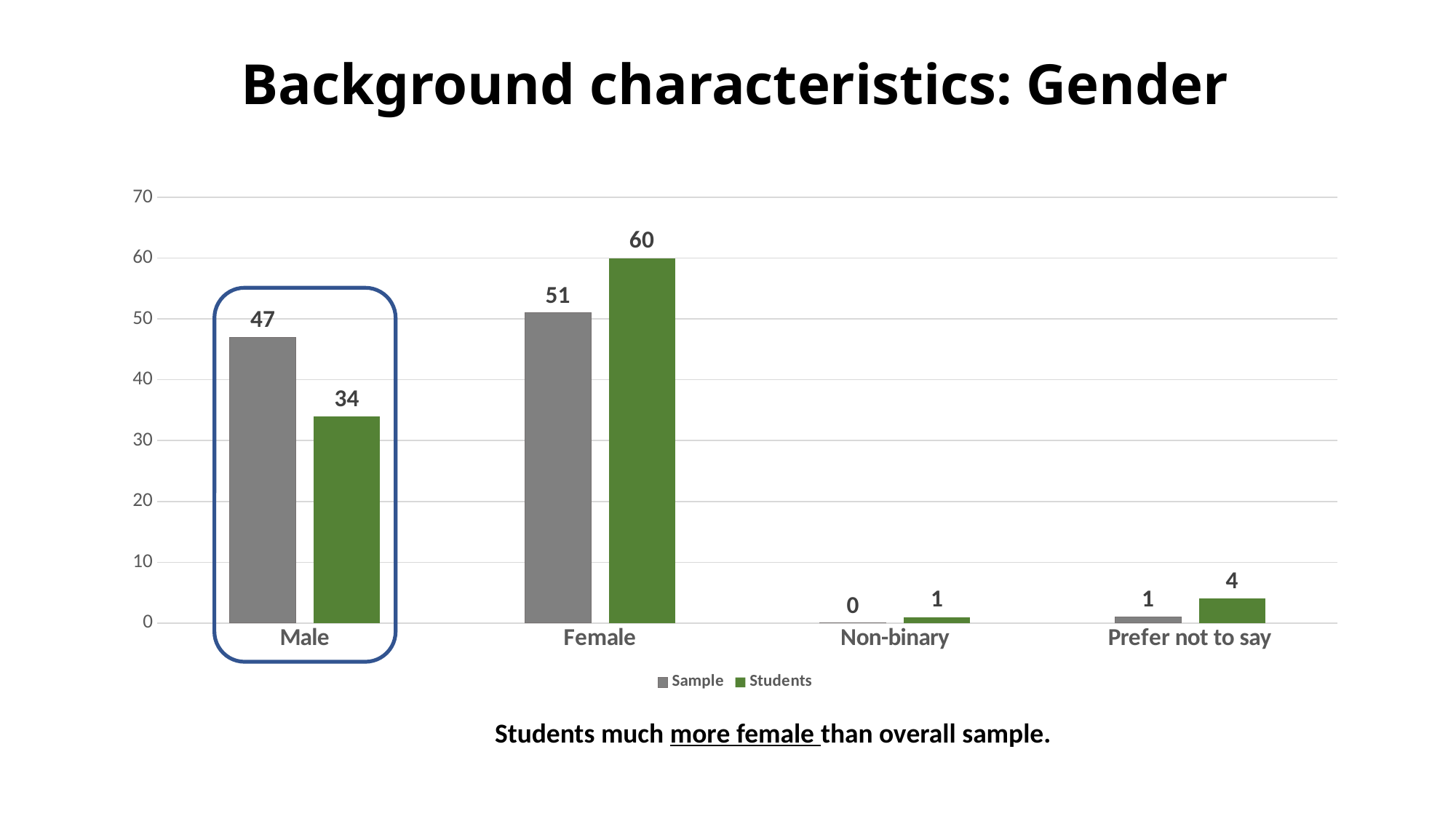
How many categories are shown on the x axis? 4 What is the difference between the Sample and Students values for Male? 13 What is the Sample value for Male? 47 Which category is highlighted with a blue rounded outline? Male Which category has the highest Students value? Female What is the Students value for Female? 60 What is the Students value for Prefer not to say? 4 Which category has the lowest Sample value? Non-binary Which is larger for Female: the Sample value or the Students value? Students How many series does the legend list? 2 What is the Sample value for Non-binary? 0 What kind of chart is shown on the slide? Bar chart